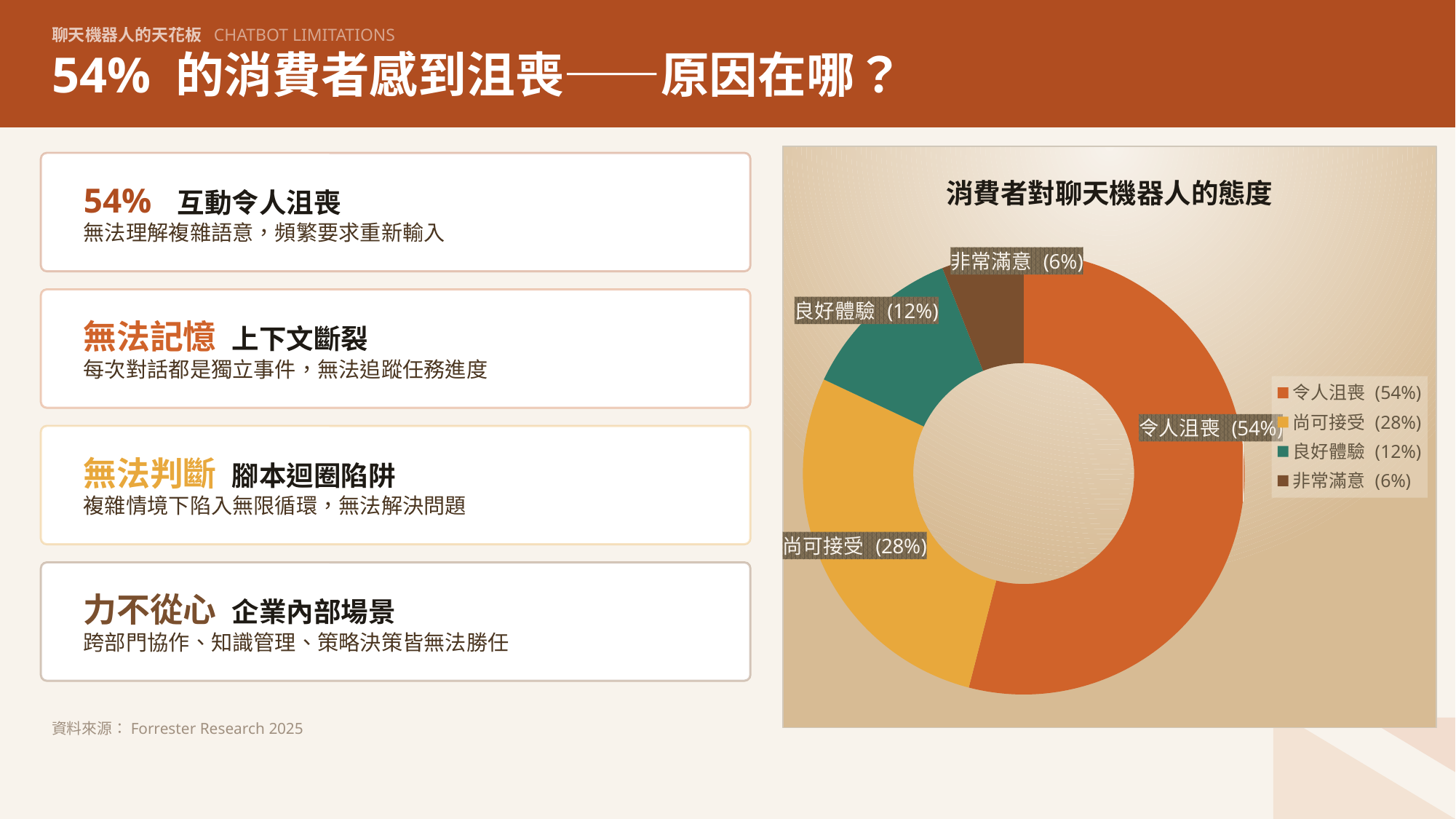
What is the difference between the shares of 令人沮喪 and 尚可接受? 26% Which category has the largest share of the pie? 令人沮喪 What is the value for 尚可接受? 28% What colour is the 尚可接受 slice in the chart? yellow/orange Which category has the smallest share of the pie? 非常滿意 How many categories does the pie chart show? 4 What is the title of the chart on the slide? 消費者對聊天機器人的態度 What share of the pie does 令人沮喪 represent? 54% What is the value for 非常滿意? 6% What kind of chart is shown on the slide? pie chart (doughnut) What is the value for 良好體驗? 12% Which is larger, the share of 良好體驗 or the share of 非常滿意? 良好體驗